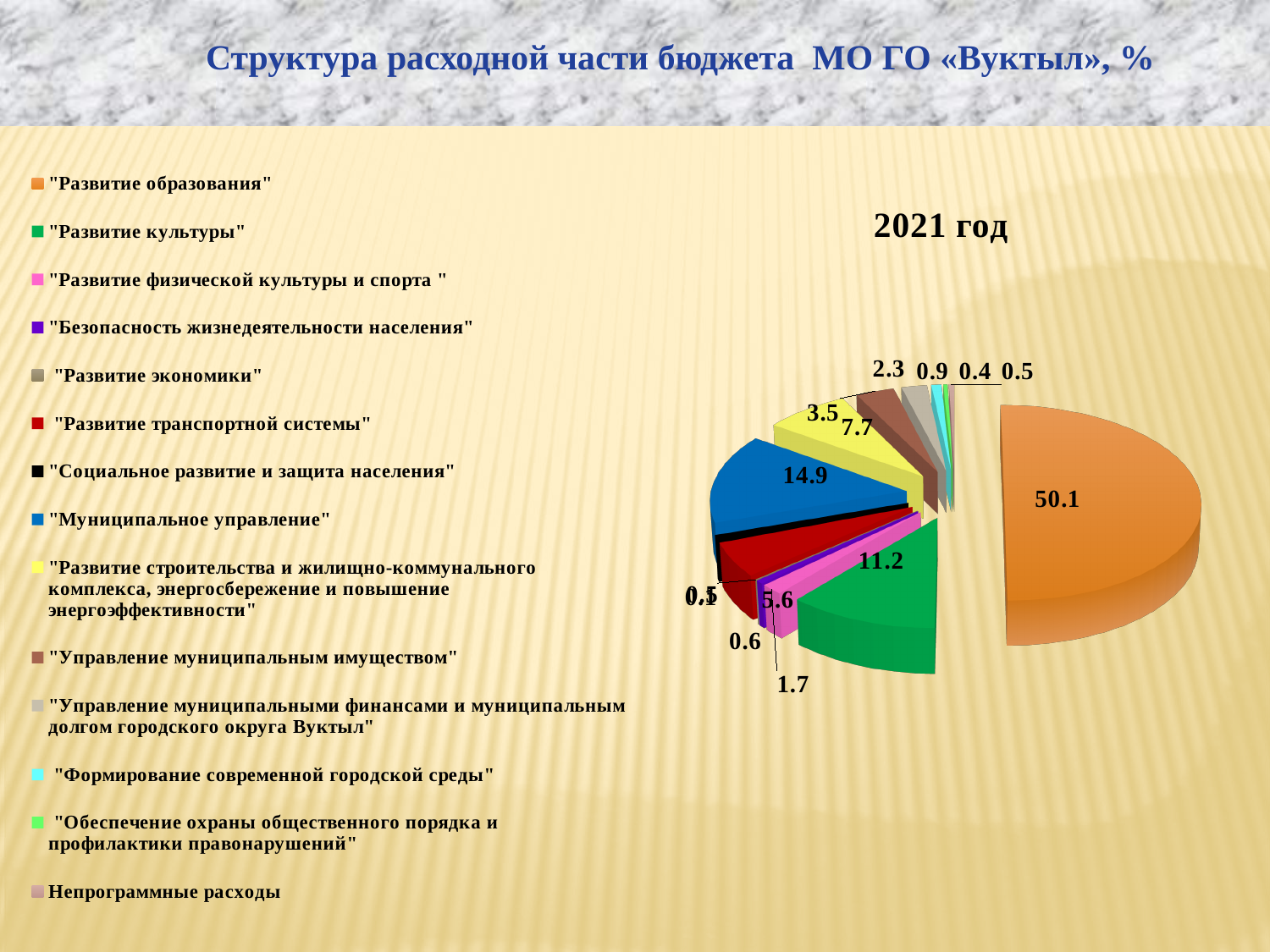
What kind of chart is shown on the slide? pie chart What year does the chart title refer to? 2021 год What colour is the slice for "Развитие образования"? orange What is the difference between the values for "Развитие образования" and "Муниципальное управление"? 35.2 What is the value for "Развитие физической культуры и спорта"? 1.7 What is the value for "Развитие культуры"? 11.2 Which is larger, "Муниципальное управление" or "Развитие культуры"? "Муниципальное управление" Which category has the largest share of the budget expenditure? "Развитие образования" What is the value for "Развитие образования"? 50.1 How many categories does the legend list? 14 What is the value for "Развитие строительства и жилищно-коммунального комплекса, энергосбережение и повышение энергоэффективности"? 7.7 What is the value for "Муниципальное управление"? 14.9